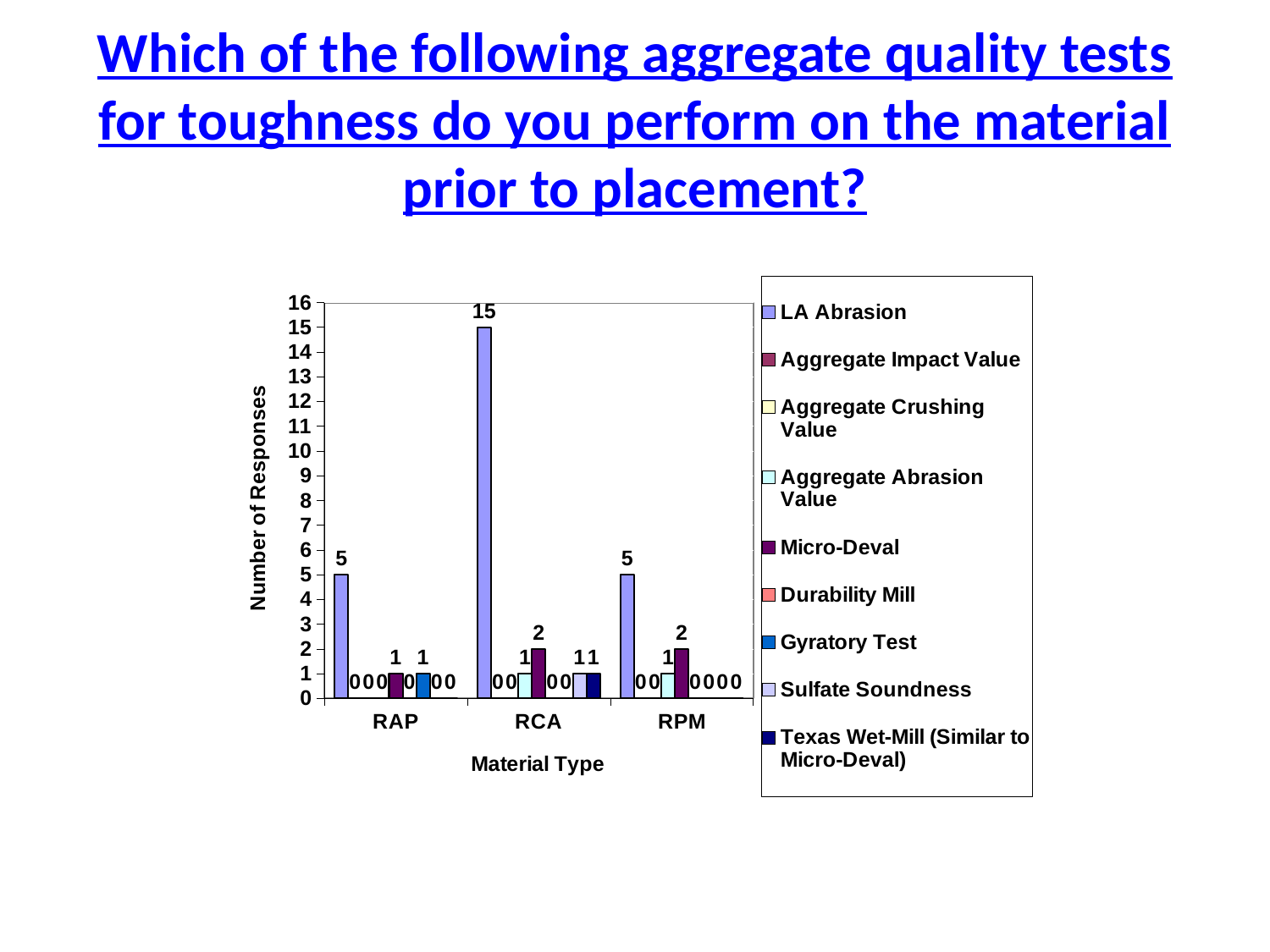
What is the number of responses for Gyratory Test for RAP? 1 Is the value for LA Abrasion for RCA greater or less than 10? greater Which material type has the highest number of responses for LA Abrasion? RCA What is the difference between the LA Abrasion responses for RCA and for RAP? 10 What kind of chart is shown on the slide? Bar chart What is the number of responses for LA Abrasion for RAP? 5 How many series does the legend list? 9 Which is larger for RCA: the number of responses for Micro-Deval or for Sulfate Soundness? Micro-Deval What is the label of the y axis? Number of Responses How many material types are shown on the x axis? 3 What is the number of responses for Micro-Deval for RPM? 2 What is the number of responses for LA Abrasion for RCA? 15